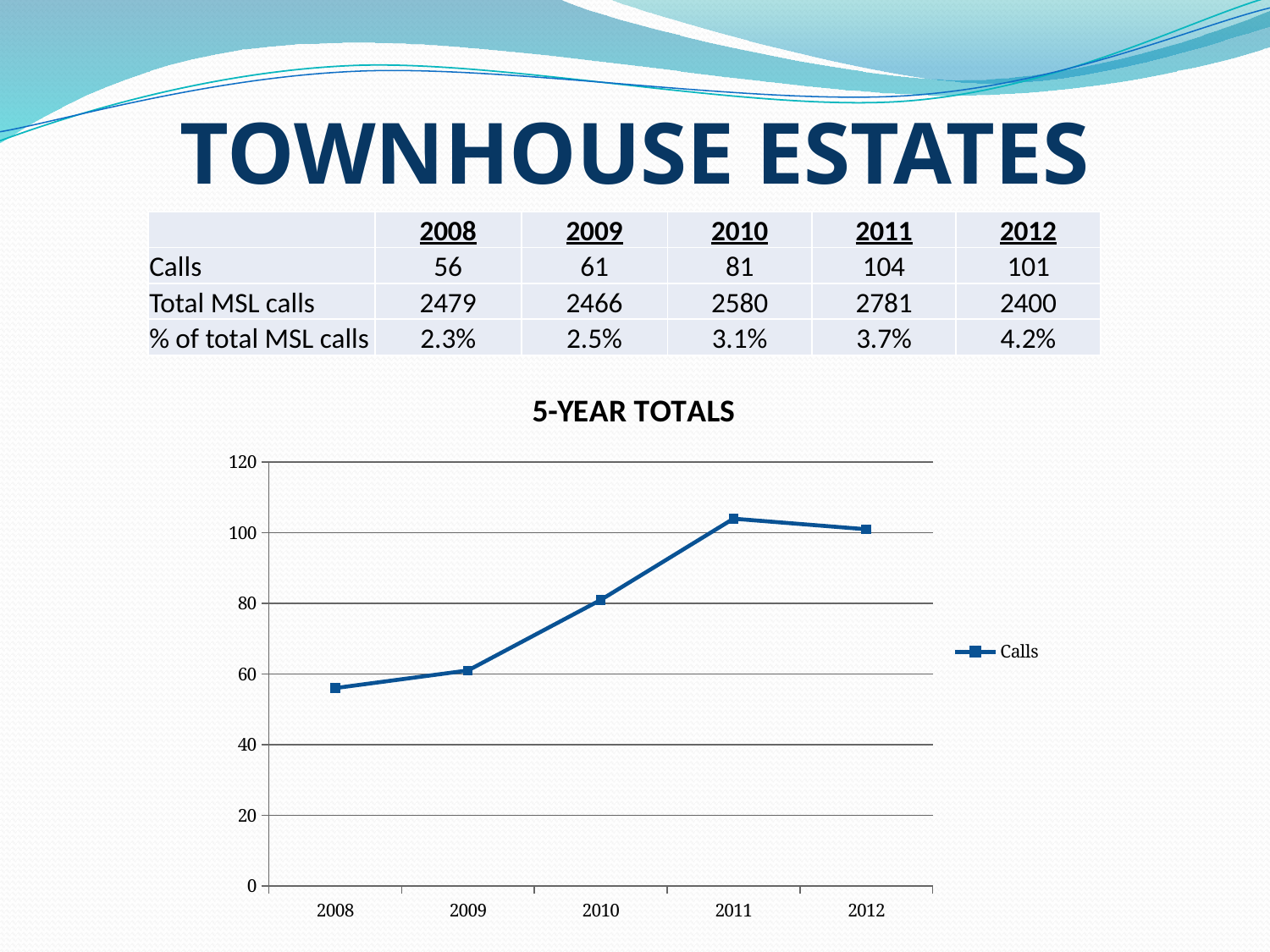
Which is larger in the 5-YEAR TOTALS chart, Calls in 2009 or Calls in 2010? 2010 Is the value for Calls in 2012 greater or less than 100? greater Which year has the highest number of Calls in the 5-YEAR TOTALS chart? 2011 What kind of chart is shown under the title 5-YEAR TOTALS? line chart Is the value for Calls in 2010 greater or less than 80? greater What is the name of the series shown in the legend of the 5-YEAR TOTALS chart? Calls According to the table on the slide, what is the number of Calls plotted for 2011? 104 How many series does the legend of the 5-YEAR TOTALS chart list? 1 How many years are plotted on the x axis of the 5-YEAR TOTALS chart? 5 Is the value for Calls in 2008 greater or less than 60? less Which year has the lowest number of Calls in the 5-YEAR TOTALS chart? 2008 Do the Calls values rise or fall from 2008 to 2011 in the 5-YEAR TOTALS chart? rise